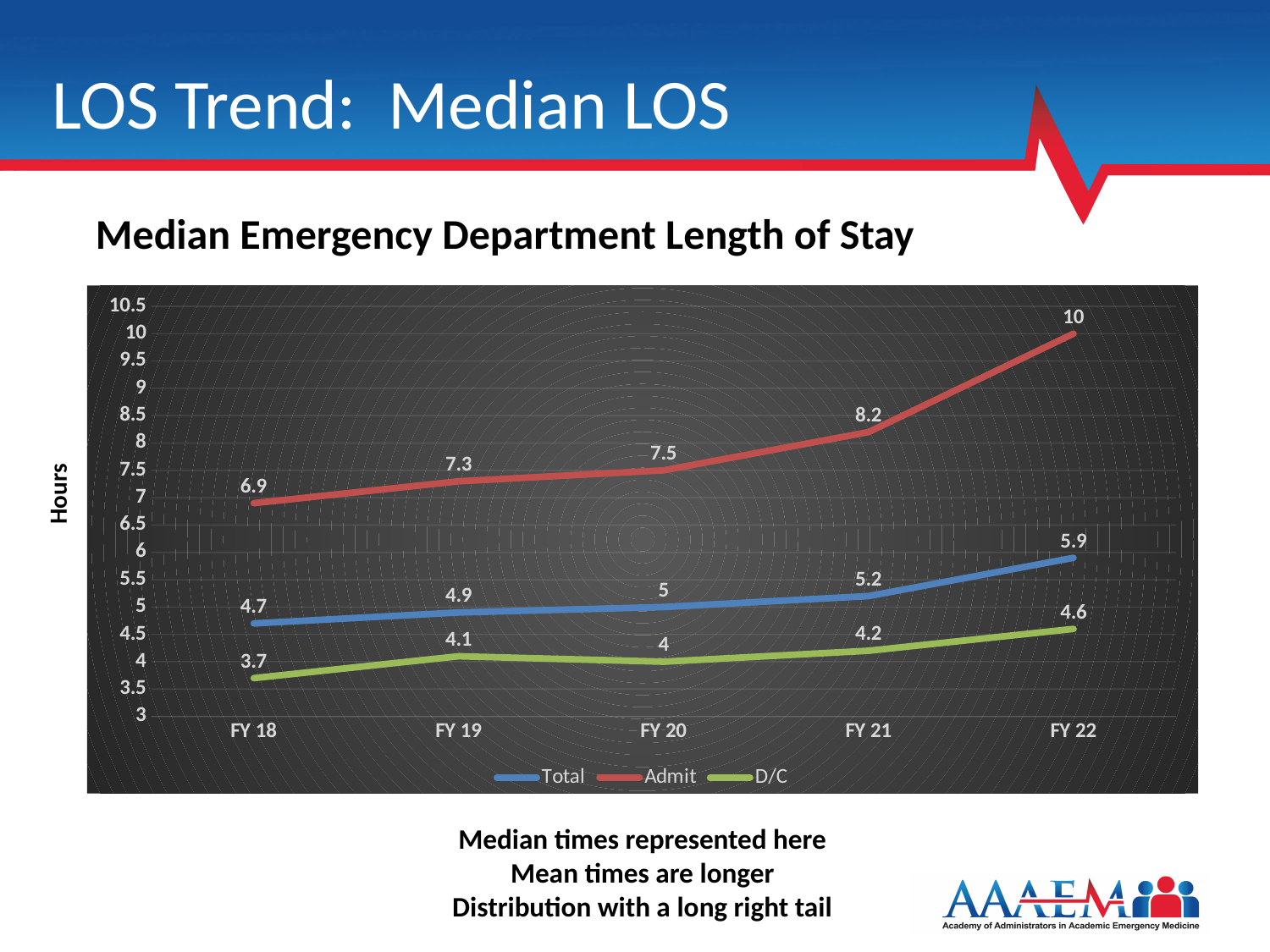
What is the difference between the Admit and D/C values in FY 22? 5.4 What is the D/C median length of stay in FY 18? 3.7 How many series does the legend list? 3 How many fiscal years are shown on the x axis? 5 What is the Admit median length of stay in FY 22? 10 In which fiscal year is the Admit median length of stay highest? FY 22 In which fiscal year is the D/C median length of stay lowest? FY 18 Does the Admit series rise or fall from FY 18 to FY 22? Rise What kind of chart is shown on the slide? Line chart By how much did the Total median length of stay increase from FY 18 to FY 22? 1.2 Which is larger in FY 21, the Total value or the D/C value? Total What is the Total median length of stay in FY 20? 5